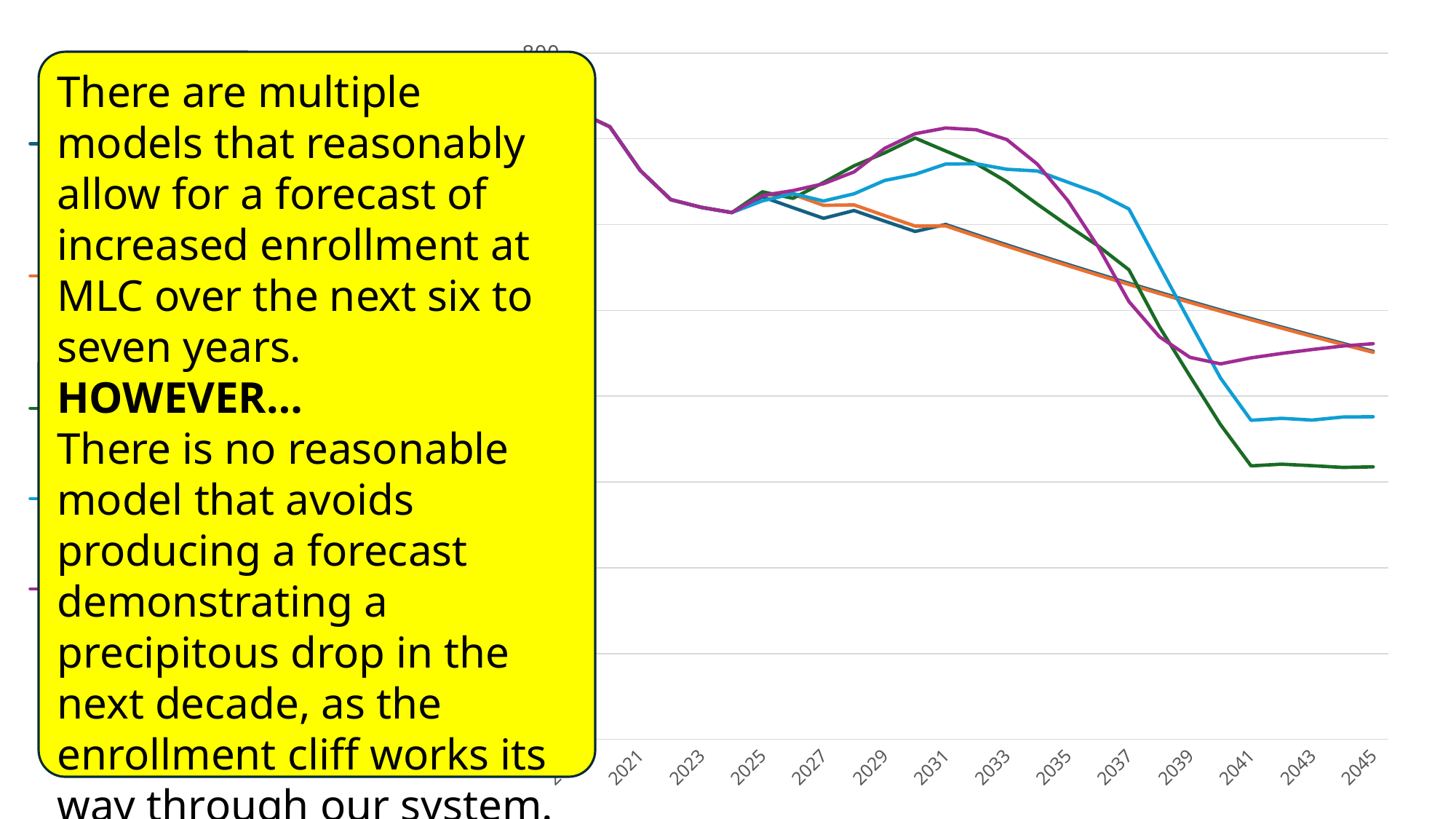
Does the dark green line rise or fall between 2031 and 2041? fall What is the first year label readable on the x axis to the right of the yellow text box? 2021 Does the light blue line rise or fall between 2037 and 2041? fall What kind of chart is shown on the slide? line chart At 2041, which is higher: the purple line or the dark green line? the purple line Which line is the lowest at 2045? the dark green line How many coloured lines are plotted on the chart? 5 What is the last year label shown on the x axis of the chart? 2045 At 2045, which is higher: the light blue line or the dark green line? the light blue line Does the orange line rise or fall between 2031 and 2045? fall Which line reaches the highest point on the chart around 2031? the purple line